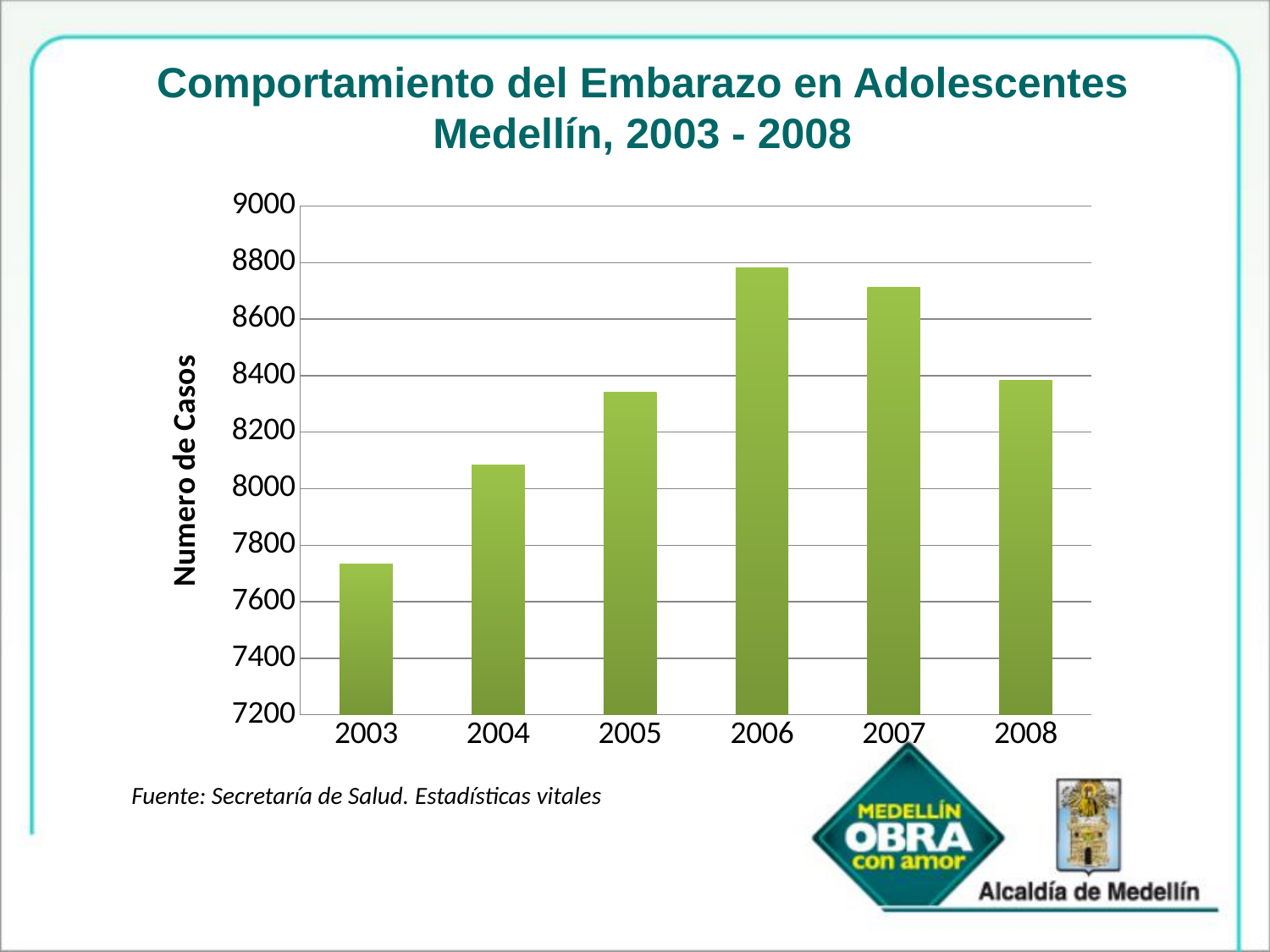
Is the value for 2008 greater or less than 8200? greater Which year has more cases, 2004 or 2005? 2005 What kind of chart is shown on the slide? bar chart Is the value for 2004 greater or less than 8000? greater How many years are shown on the x axis of the chart? 6 Is the value for 2003 greater or less than 7800? less Which year has the highest number of cases? 2006 Which year has the lowest number of cases? 2003 What is the label of the vertical axis of the chart? Numero de Casos Do the values rise or fall from 2003 to 2006? rise